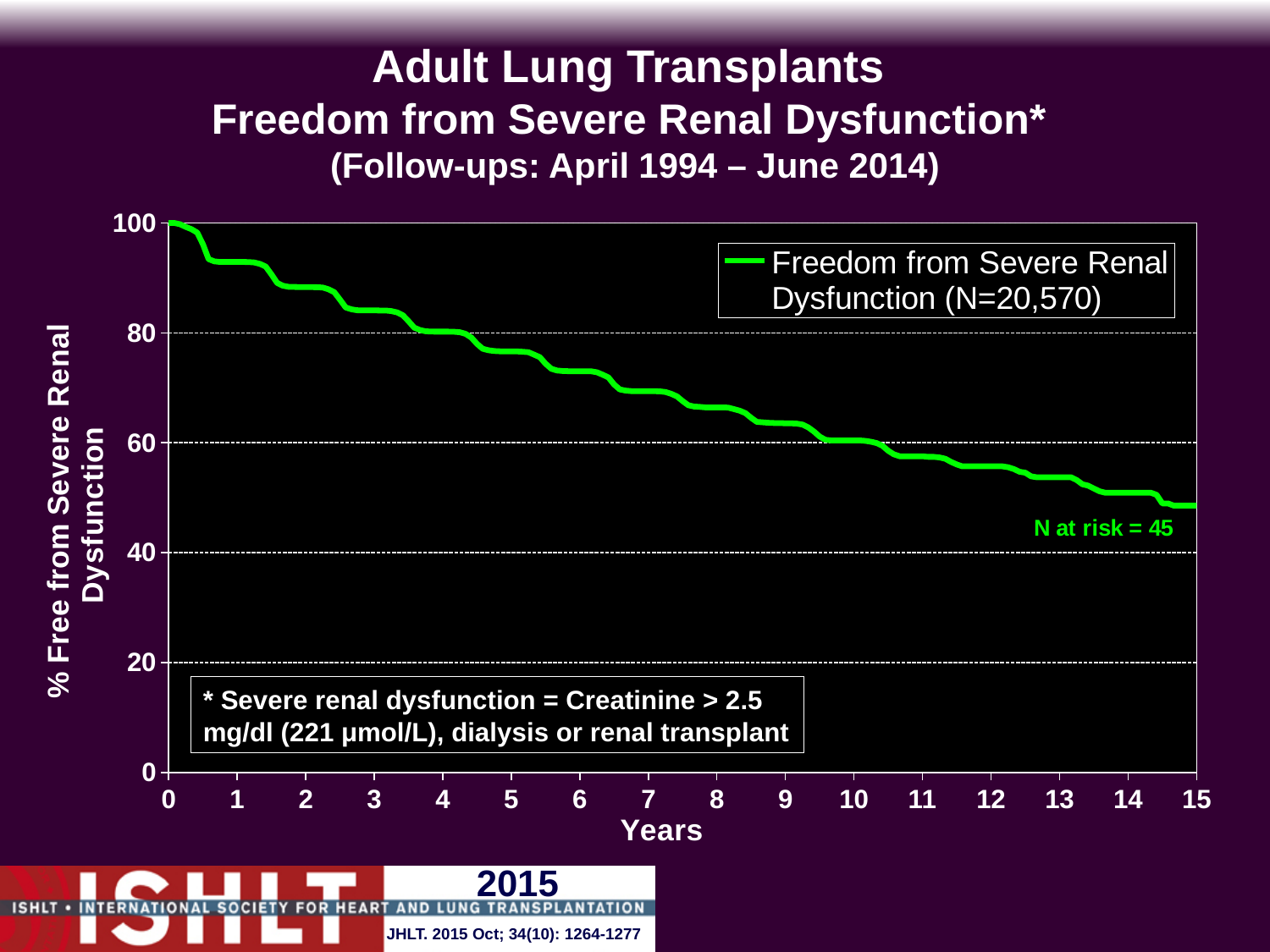
Is the value at year 7 greater or less than 80? less Is the value at year 1 greater or less than 80? greater What is the N at risk shown at the end of the curve? 45 How many series does the legend list? 1 What is the label of the x axis? Years Is the value at year 5 greater or less than 60? greater What is the legend entry for the plotted line? Freedom from Severe Renal Dysfunction (N=20,570) Which is larger, the value at year 2 or the value at year 12? year 2 What is the value of the curve at year 0? 100 Do the values rise or fall as the years increase along the x axis? fall What kind of chart is shown on the slide? line chart